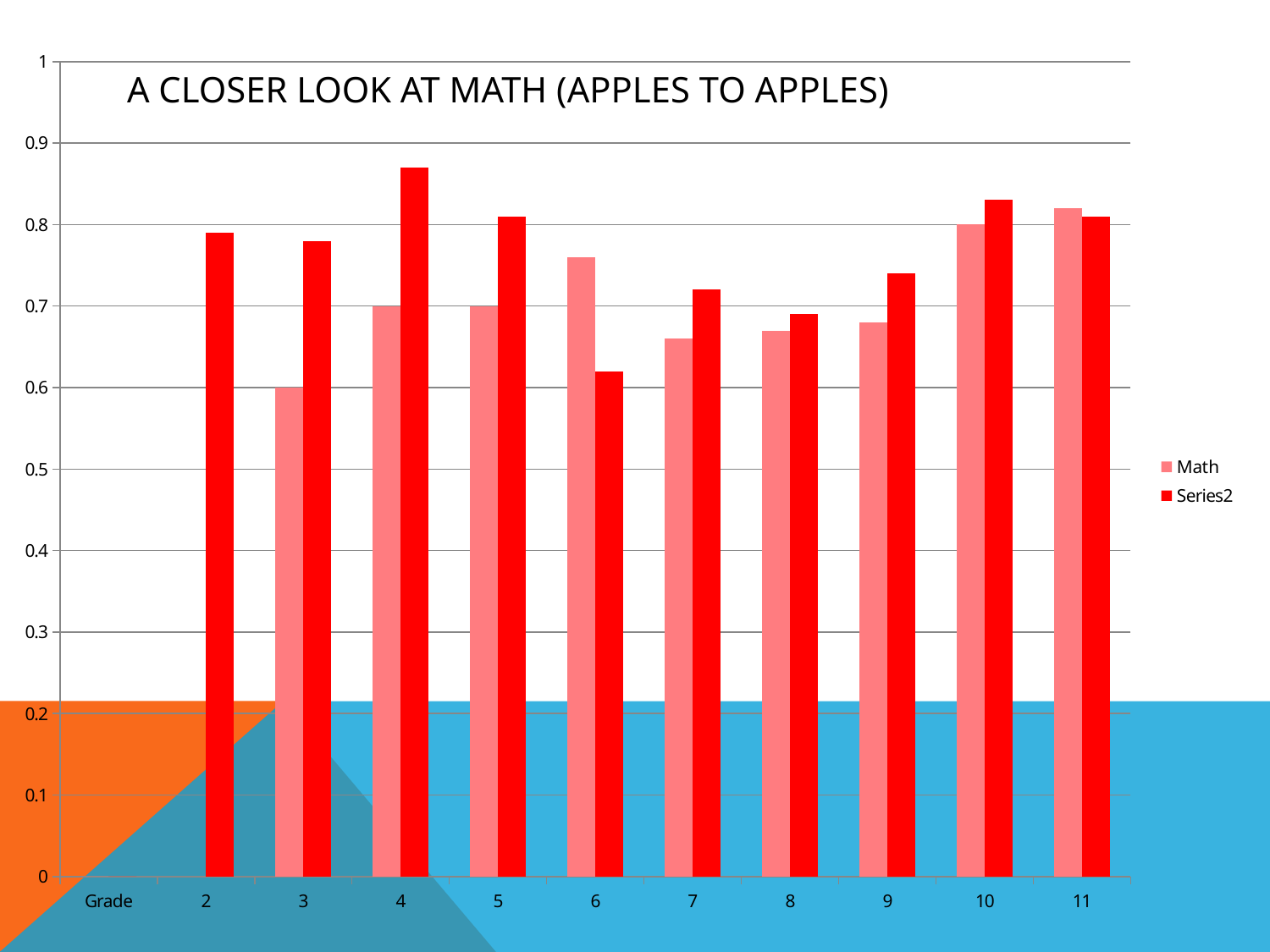
At grade 6, which is larger, the Math value or the Series2 value? Math What are the names of the two series in the legend? Math and Series2 For which grade is the Math value lowest? 3 Is the Series2 value for grade 6 greater or less than 0.7? less What is the title of the chart? A CLOSER LOOK AT MATH (APPLES TO APPLES) Is the Series2 value for grade 4 greater or less than 0.8? greater What type of chart is shown on the slide? Bar chart For which grade is the Series2 value lowest? 6 How many categories are shown on the x axis? 11 For which grade is the Series2 value highest? 4 How many series does the legend list? 2 At grade 3, which is larger, the Math value or the Series2 value? Series2